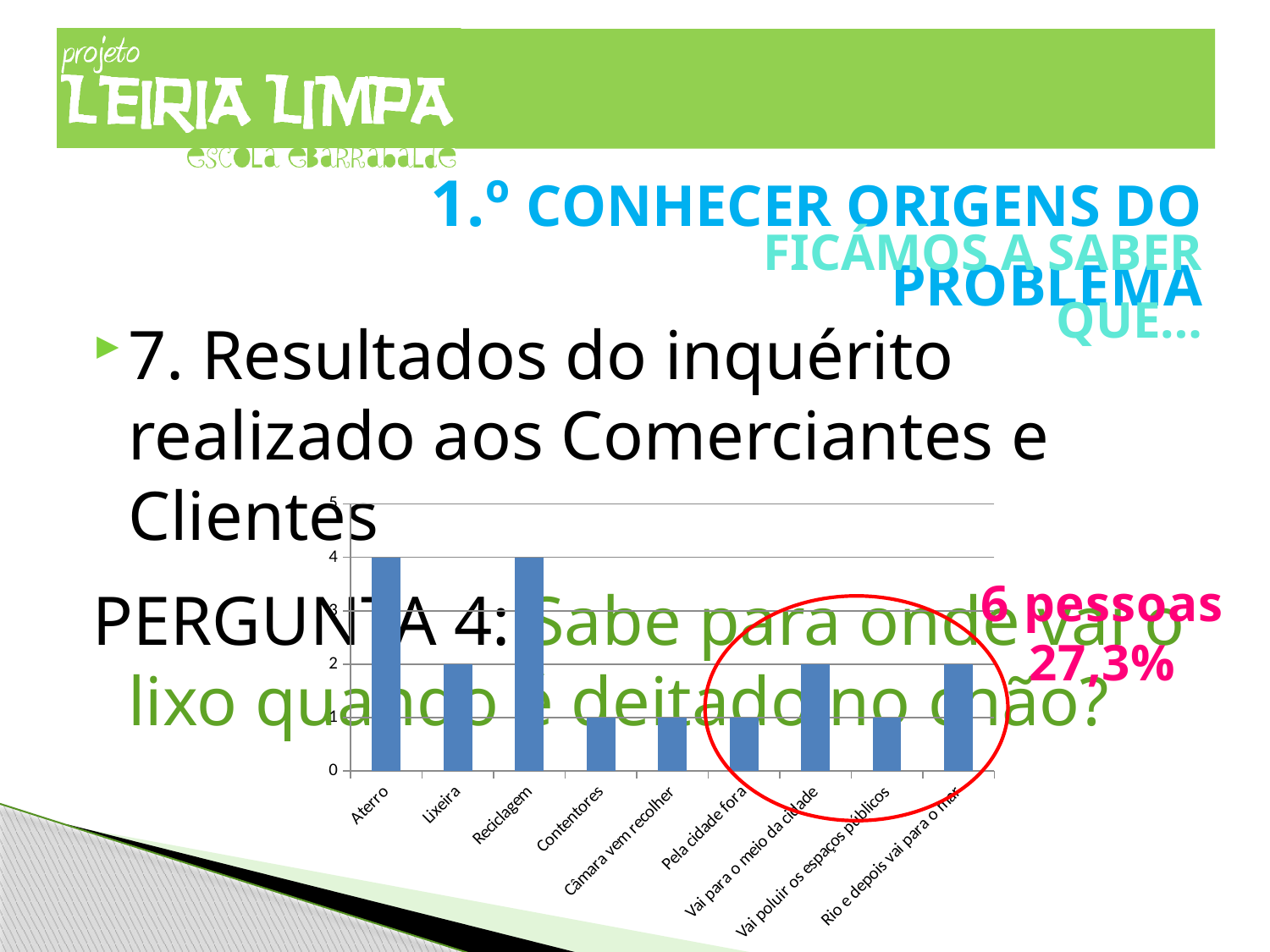
What is the value for Vai para o meio da cidade? 2 What is the difference between the values for Aterro and Lixeira? 2 What is the value for Rio e depois vai para o mar? 2 What kind of chart is shown on the slide? bar chart What is the value for Contentores? 1 Which is larger, the value for Reciclagem or the value for Contentores? Reciclagem What is the value for Aterro? 4 Is the value for Aterro greater or less than 3? greater What percentage is written in the annotation next to the circled bars? 27,3% How many categories are shown on the x axis of the chart? 9 What is the value for Lixeira? 2 What is the value for Reciclagem? 4